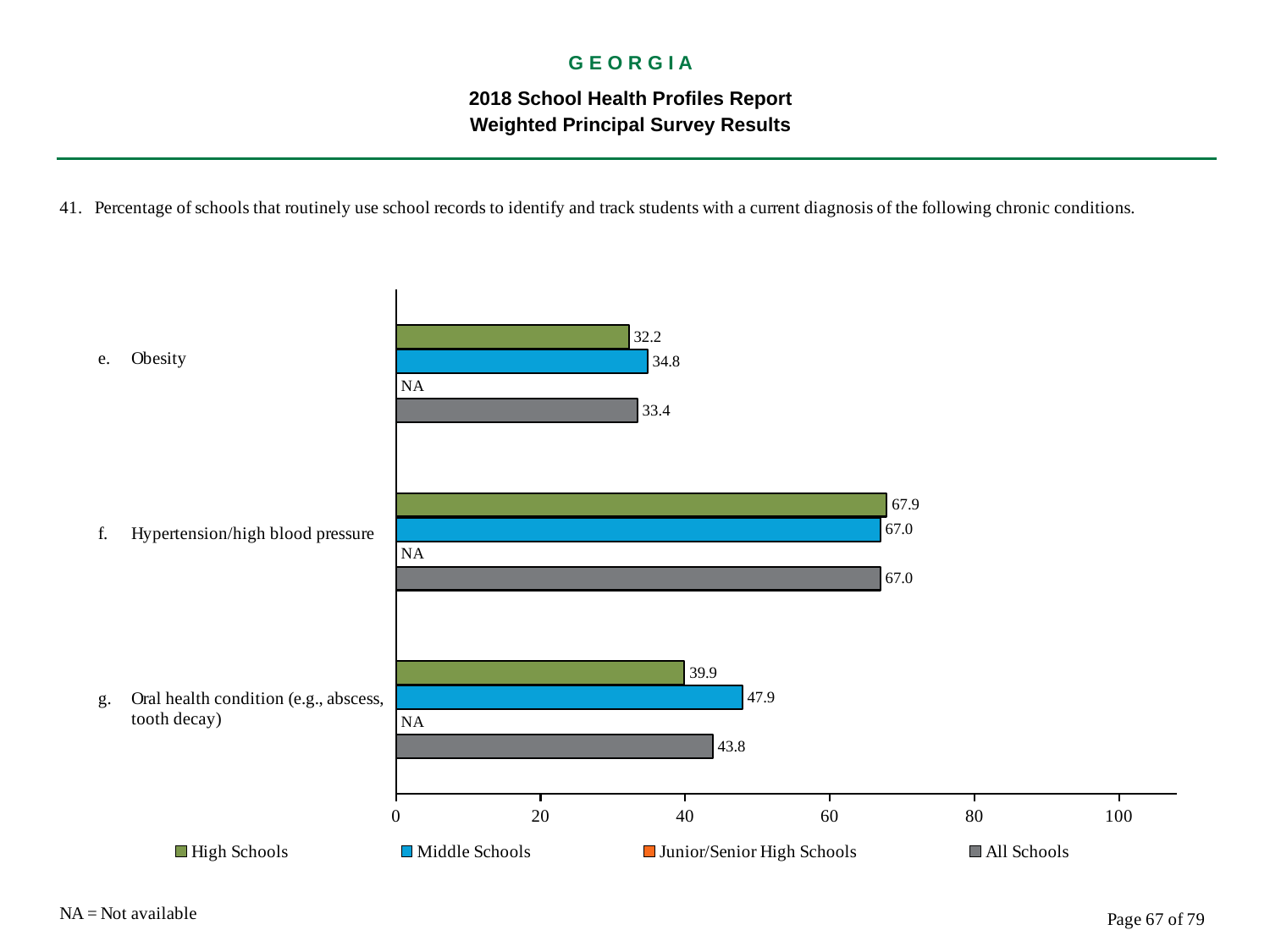
What is the difference between the Middle Schools and High Schools values for Oral health condition (e.g., abscess, tooth decay)? 8.0 What is the value for All Schools for Hypertension/high blood pressure? 67.0 Which condition has the lowest value for All Schools? Obesity Is the value for All Schools for Oral health condition (e.g., abscess, tooth decay) greater or less than 40? greater What kind of chart is shown on the slide? bar chart What value is shown for Junior/Senior High Schools for Obesity? NA Which condition has the highest value for High Schools? Hypertension/high blood pressure For Obesity, which is larger: the value for Middle Schools or the value for High Schools? Middle Schools What is the value for High Schools for Obesity? 32.2 How many chronic conditions are shown on the chart? 3 What is the value for Middle Schools for Oral health condition (e.g., abscess, tooth decay)? 47.9 How many series does the legend list? 4